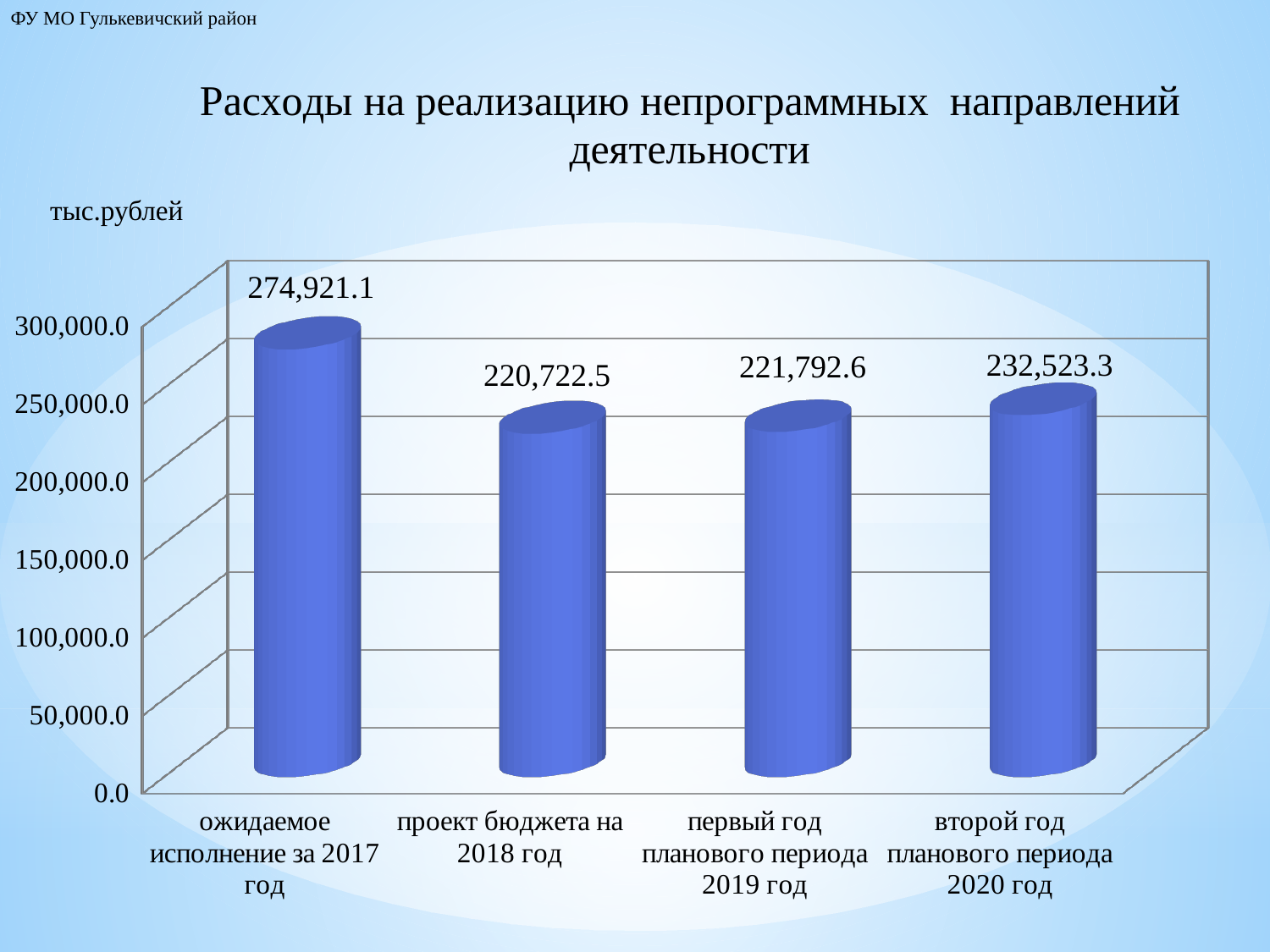
What is the value for 'первый год планового периода 2019 год'? 221,792.6 What kind of chart is shown on the slide? bar chart How many categories are shown on the x axis? 4 Which category has the lowest value? проект бюджета на 2018 год What is the difference between the value for 2017 (ожидаемое исполнение) and the value for 2018 (проект бюджета)? 54,198.6 Which category has the highest value? ожидаемое исполнение за 2017 год What is the value for 'проект бюджета на 2018 год'? 220,722.5 What is the value for 'второй год планового периода 2020 год'? 232,523.3 Is the value for 'проект бюджета на 2018 год' greater or less than 250,000.0? less Which is larger: the value for 2020 (второй год планового периода) or the value for 2019 (первый год планового периода)? второй год планового периода 2020 год What is the difference between the value for 2020 and the value for 2019 (плановый период)? 10,730.7 What is the value for 'ожидаемое исполнение за 2017 год'? 274,921.1